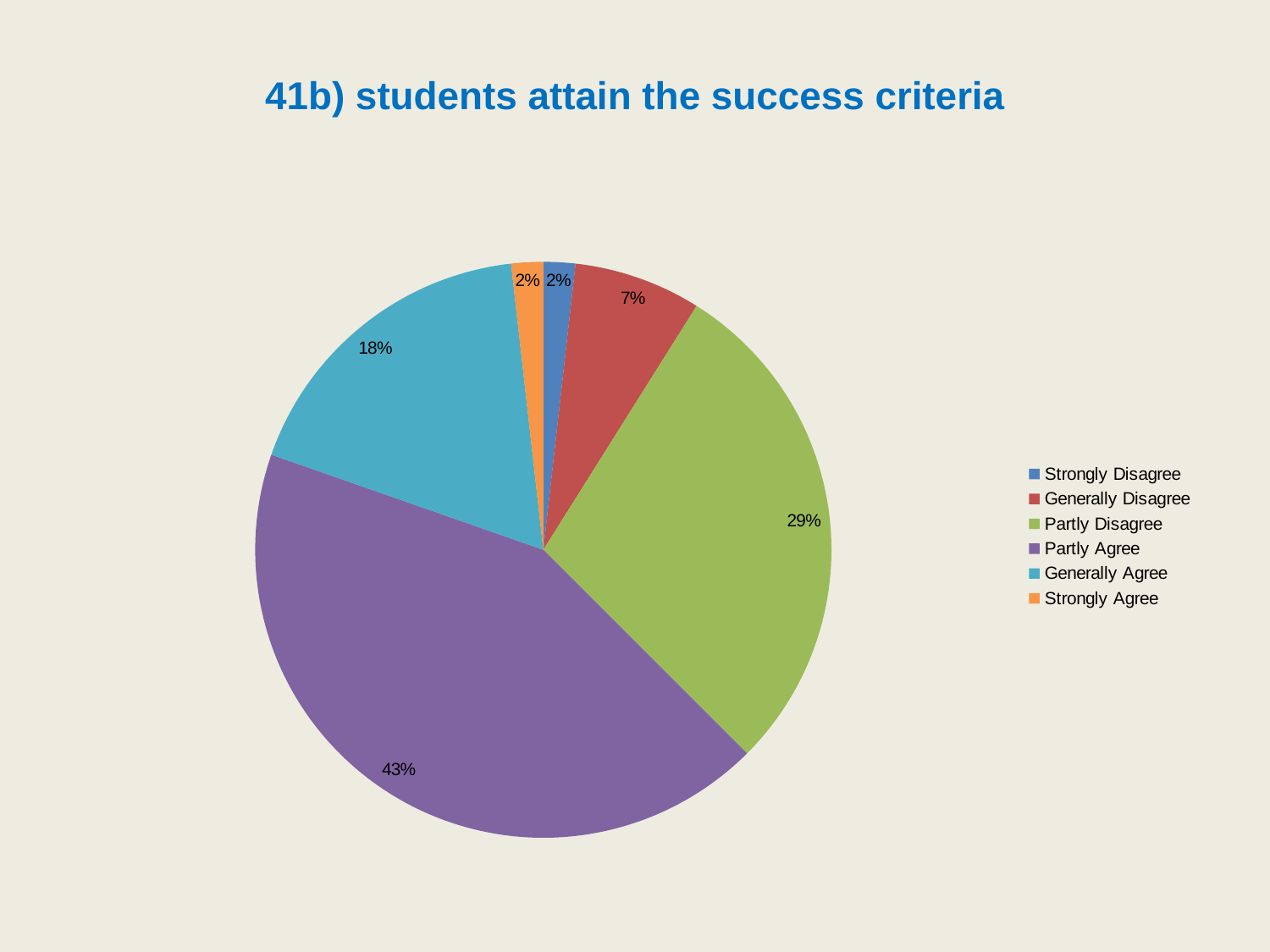
Which is larger, the share for Generally Agree or the share for Generally Disagree? Generally Agree What percentage of respondents chose Strongly Disagree? 2% What percentage of respondents chose Generally Agree? 18% What kind of chart is shown on the slide? pie chart How many categories does the legend list? 6 Which response category has the largest share of the pie? Partly Agree What is the title of the chart? 41b) students attain the success criteria What percentage of respondents chose Partly Agree? 43% What is the difference in percentage points between Partly Agree and Partly Disagree? 14 What percentage of respondents chose Generally Disagree? 7% What is the combined share of Partly Agree and Generally Agree? 61% What percentage of respondents chose Partly Disagree? 29%